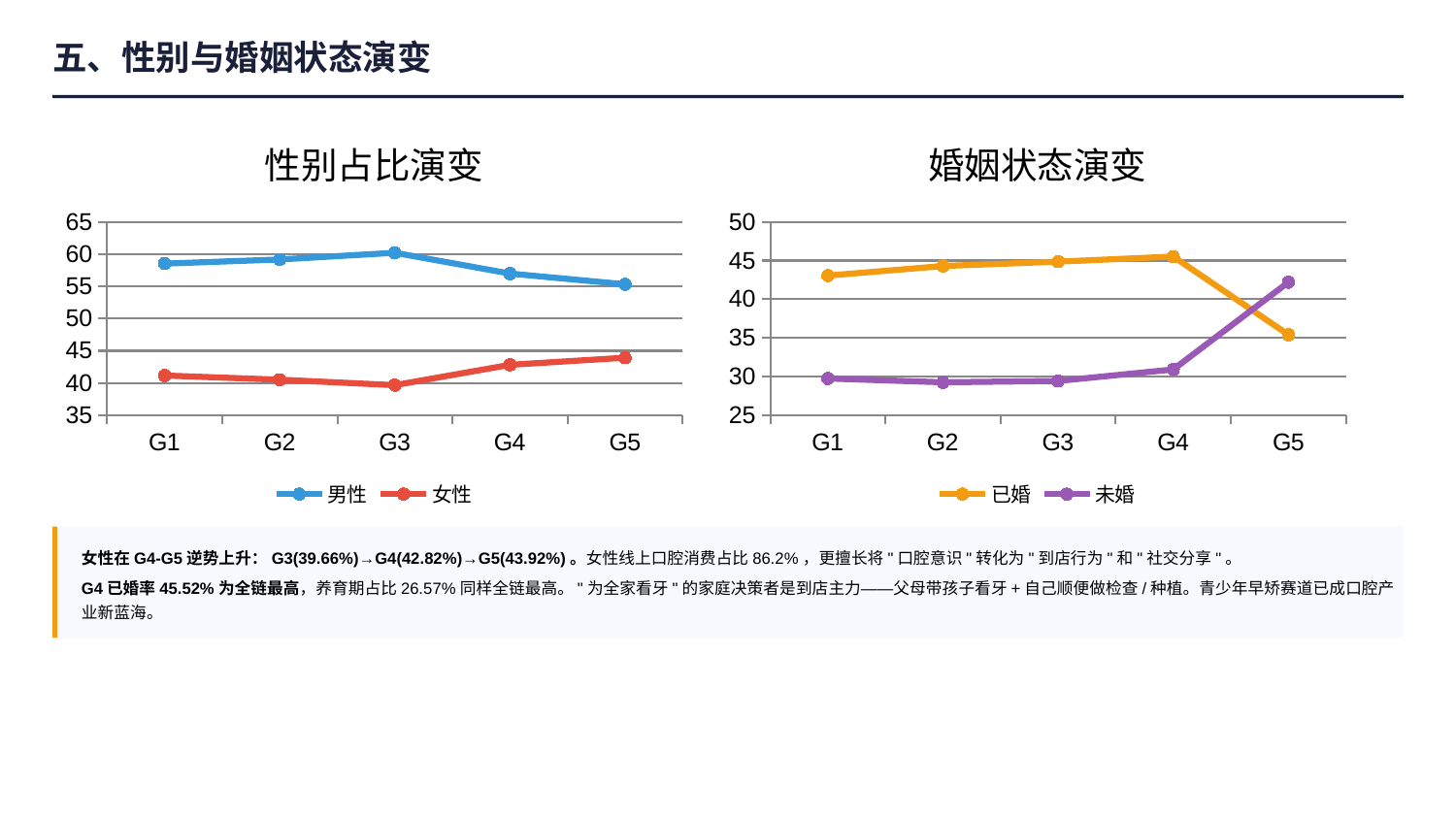
What are the two legend entries of the 婚姻状态演变 chart? 已婚, 未婚 In the 婚姻状态演变 chart, at G5, which is larger: 已婚 or 未婚? 未婚 In the 性别占比演变 chart, is the value for 男性 at G1 greater or less than 55? greater How many series does the legend of the 性别占比演变 chart list? 2 In the 性别占比演变 chart, at G5, which is larger: 男性 or 女性? 男性 In the 婚姻状态演变 chart, does the 已婚 line rise or fall from G4 to G5? fall In the 婚姻状态演变 chart, at which point is the 已婚 value lowest? G5 In the 婚姻状态演变 chart, is the value for 未婚 at G5 greater or less than 40? greater How many points are on the x axis of the 婚姻状态演变 chart? 5 In the 性别占比演变 chart, at which point is the 男性 value highest? G3 What kind of chart is the 性别占比演变 chart? line chart In the 性别占比演变 chart, is the value for 女性 at G1 greater or less than 45? less